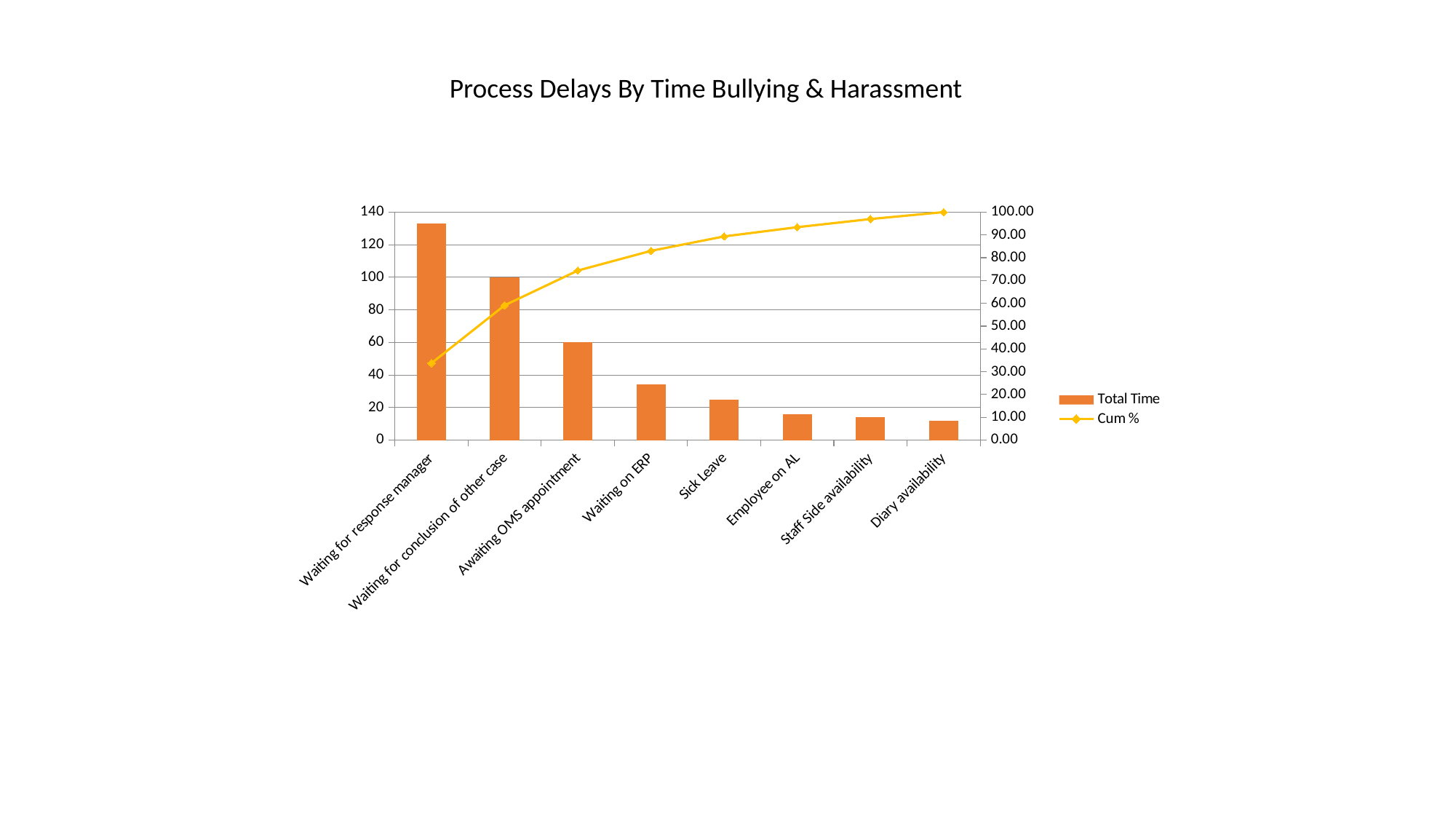
What is the title of the chart? Process Delays By Time Bullying & Harassment Is the Total Time for Employee on AL greater or less than 20? less What is the Total Time value for Waiting for conclusion of other case? 100 Which has a larger Total Time, Sick Leave or Employee on AL? Sick Leave Is the Total Time for Waiting on ERP greater or less than 40? less How many series does the legend list? 2 How many categories are shown on the x axis? 8 What are the two series named in the legend? Total Time and Cum % Is the Total Time for Waiting for response manager greater or less than 120? greater Which category has the highest Total Time bar? Waiting for response manager Do the Total Time bars rise or fall from left to right along the x axis? fall What is the Total Time value for Awaiting OMS appointment? 60